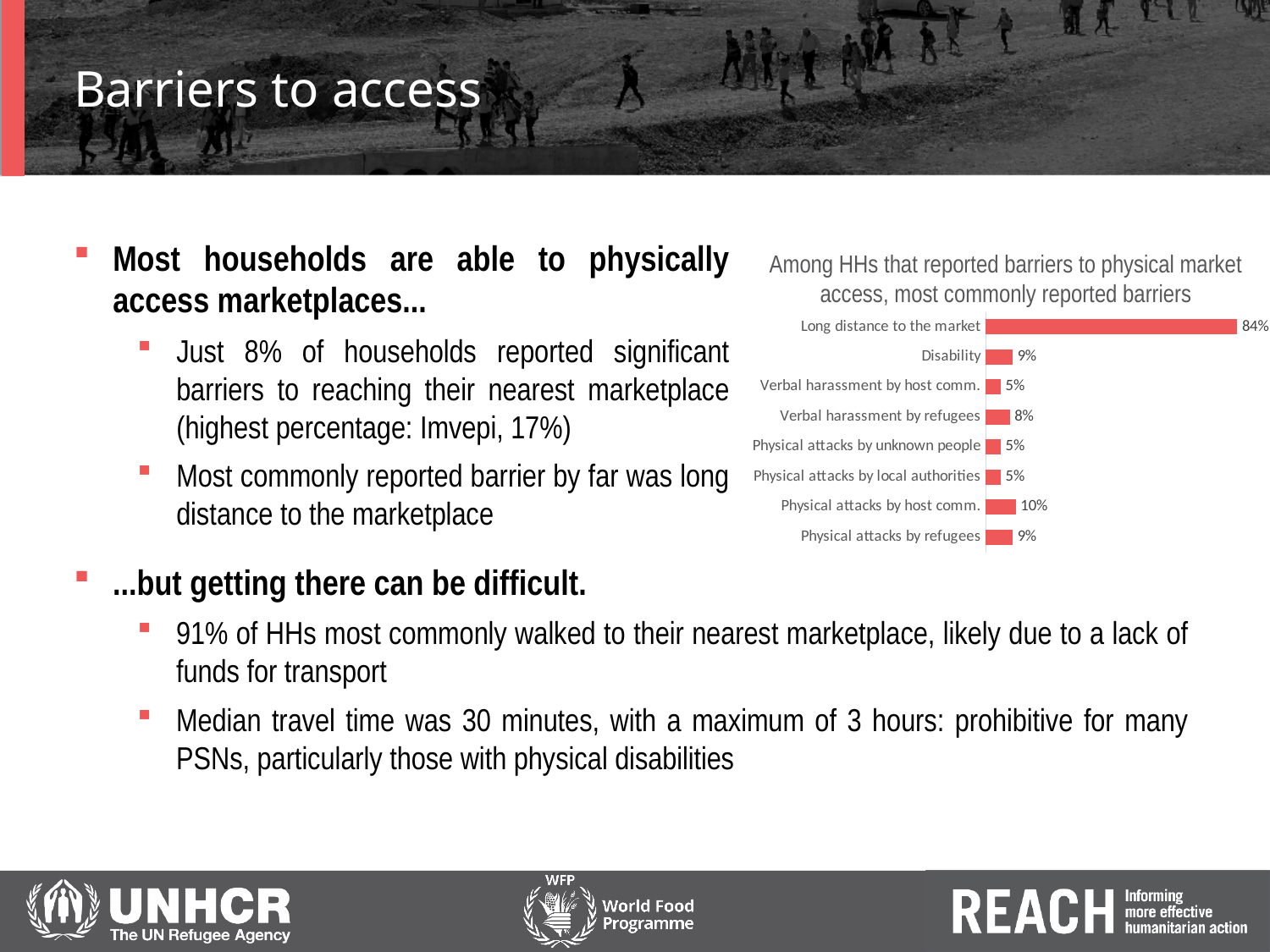
Which barrier has the highest reported percentage? Long distance to the market What is the value for Disability? 9% What is the value for Verbal harassment by refugees? 8% What percentage of households reported long distance to the market as a barrier? 84% What is the value for Physical attacks by host comm.? 10% Which is larger, the value for Physical attacks by host comm. or the value for Physical attacks by refugees? Physical attacks by host comm. What is the title of the chart? Among HHs that reported barriers to physical market access, most commonly reported barriers What is the difference between the values for Long distance to the market and Physical attacks by host comm.? 74% What type of chart is shown on the slide? Bar chart Which is larger, the value for Verbal harassment by refugees or the value for Physical attacks by unknown people? Verbal harassment by refugees How many barrier categories are shown in the chart? 8 What is the difference between the values for Disability and Verbal harassment by host comm.? 4%